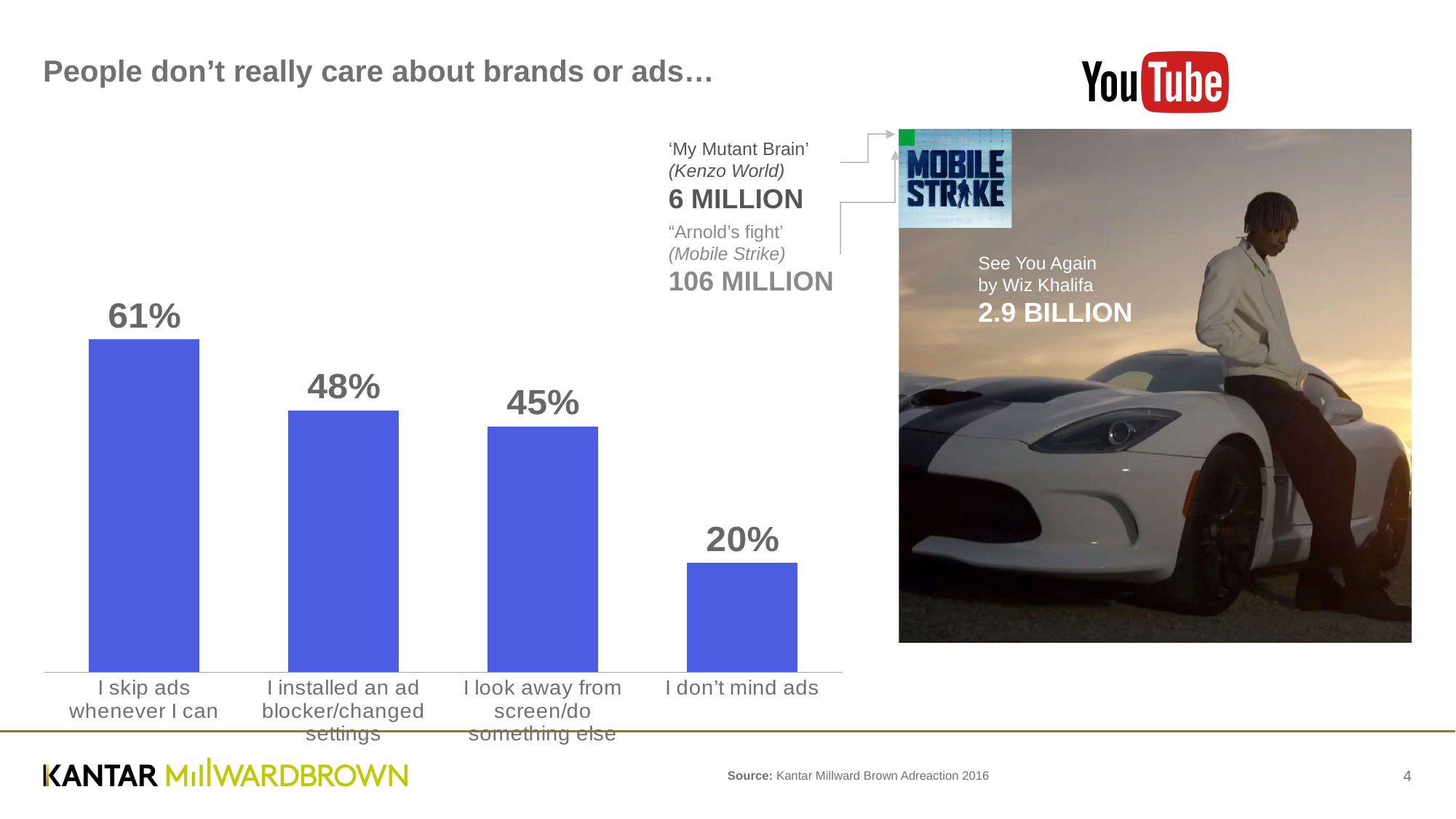
What is the value for "I installed an ad blocker/changed settings"? 48% What percentage of people say they skip ads whenever they can? 61% What is the value for "I look away from screen/do something else"? 45% What percentage of people say they don't mind ads? 20% What is the difference between the value for "I installed an ad blocker/changed settings" and the value for "I look away from screen/do something else"? 3% Which category has the highest value in the bar chart? I skip ads whenever I can What is the difference between the value for "I skip ads whenever I can" and the value for "I don't mind ads"? 41% What kind of chart is shown on the slide? Bar chart How many categories are shown in the bar chart? 4 Which is larger: the value for "I skip ads whenever I can" or the value for "I installed an ad blocker/changed settings"? I skip ads whenever I can Do the values rise or fall from left to right across the bar chart? Fall Which category has the lowest value in the bar chart? I don't mind ads